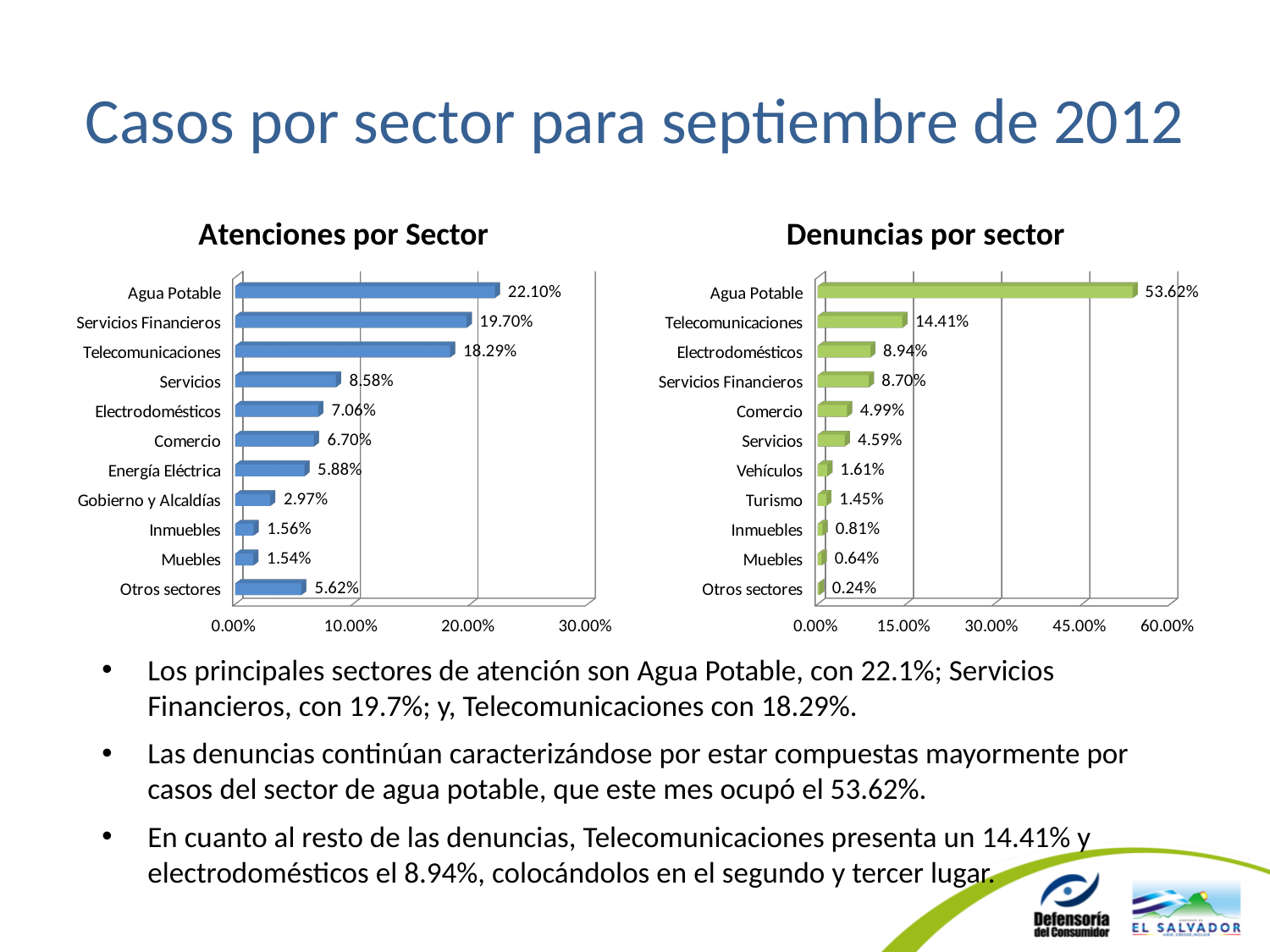
In the 'Denuncias por sector' chart, which sector has the lowest value? Otros sectores In the 'Denuncias por sector' chart, which is larger: Comercio or Servicios? Comercio In the 'Atenciones por Sector' chart, what is the difference between Agua Potable and Telecomunicaciones? 3.81% In the 'Atenciones por Sector' chart, is the value for Servicios greater or less than 10.00%? less In the 'Atenciones por Sector' chart, what is the value for Servicios Financieros? 19.70% In the 'Denuncias por sector' chart, what is the difference between Agua Potable and Telecomunicaciones? 39.21% In the 'Denuncias por sector' chart, what is the value for Electrodomésticos? 8.94% In the 'Atenciones por Sector' chart, what is the value for Gobierno y Alcaldías? 2.97% What kind of chart is 'Atenciones por Sector'? Bar chart How many sectors are shown in the 'Denuncias por sector' chart? 11 In the 'Atenciones por Sector' chart, which sector has the highest value? Agua Potable What is the title of the chart on the right side of the slide? Denuncias por sector